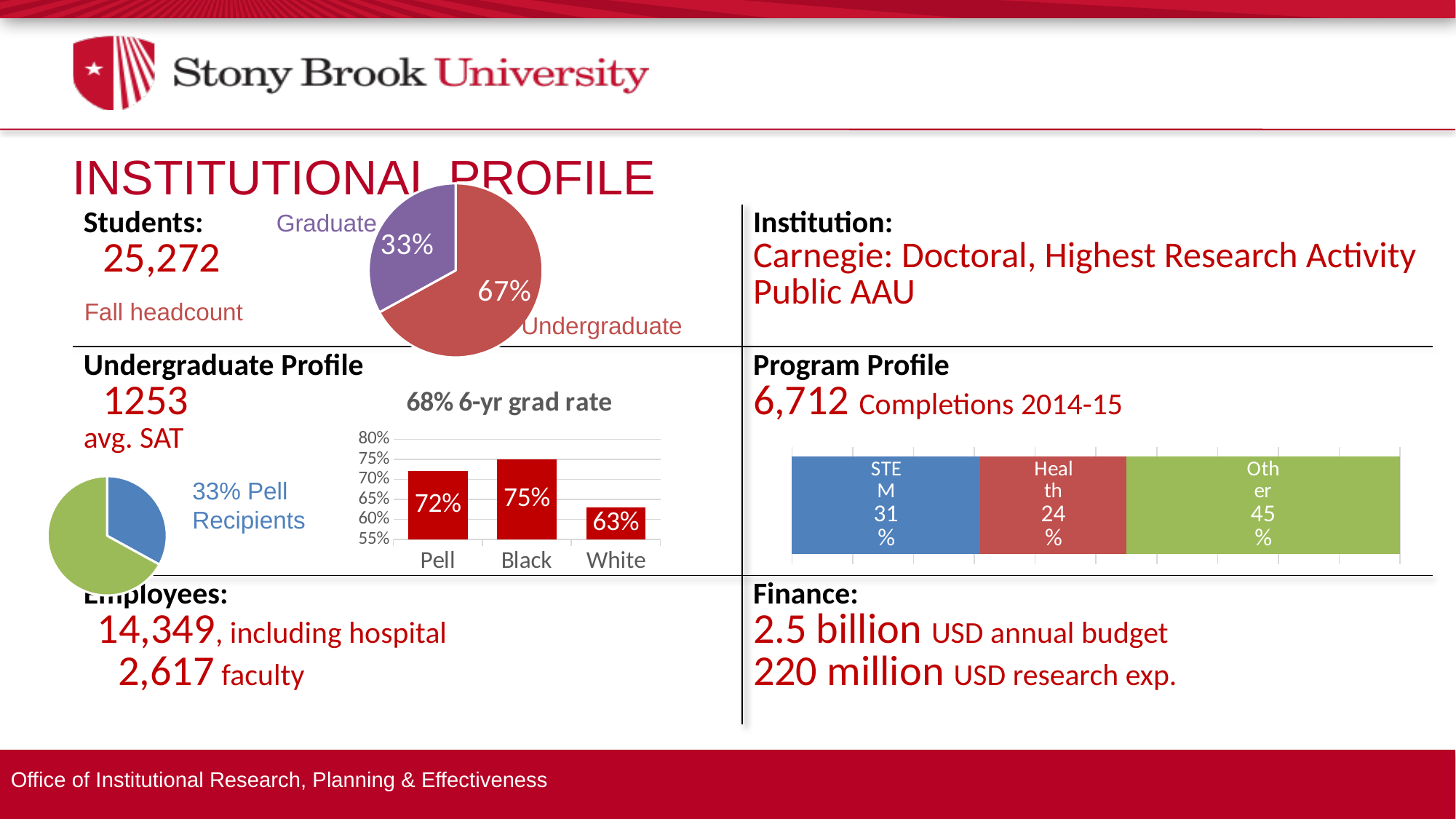
In the Program Profile stacked bar, what share is Health? 24% In the students pie chart at the top left, what share is Undergraduate? 67% In the students pie chart at the top left, what share is Graduate? 33% In the '68% 6-yr grad rate' bar chart, how many categories are shown? 3 In the '68% 6-yr grad rate' bar chart, what is the value for Black? 75% In the '68% 6-yr grad rate' bar chart, which category has the highest value? Black In the students pie chart at the top left, which slice is larger, Graduate or Undergraduate? Undergraduate In the '68% 6-yr grad rate' bar chart, which category has the lowest value? White What kind of chart is the '68% 6-yr grad rate' chart? Bar chart In the '68% 6-yr grad rate' bar chart, what is the value for White? 63% In the Program Profile stacked bar, which segment is the largest? Other In the '68% 6-yr grad rate' bar chart, what is the difference between the Pell and White values? 9%